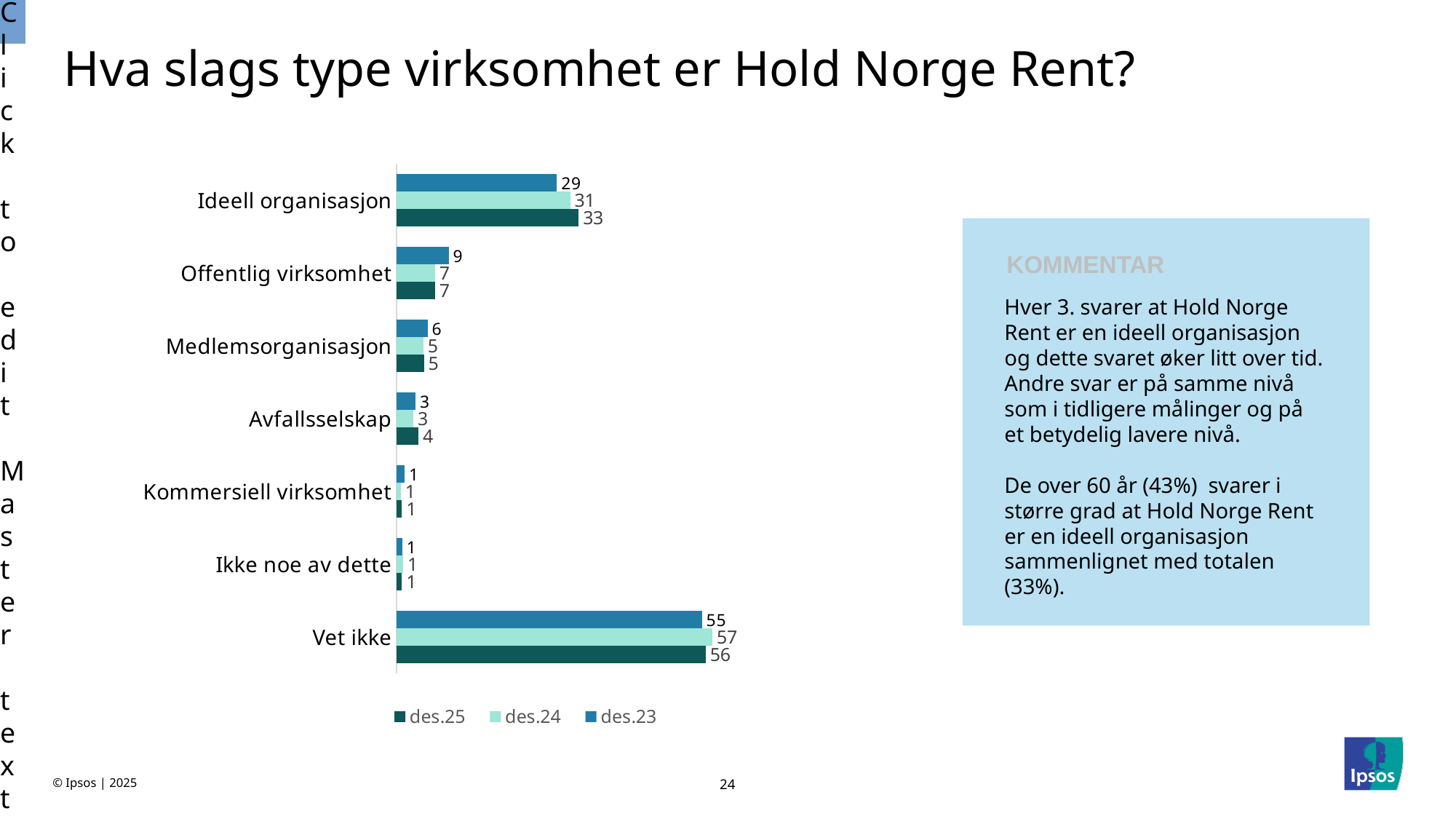
Which category has the highest value in the des.25 series? Vet ikke What is the value for Avfallsselskap in the des.25 series? 4 Which category has the lowest value in the des.23 series? Kommersiell virksomhet and Ikke noe av dette (both 1) Which series is shown in the darkest colour in the legend? des.25 What is the difference between the des.25 and des.23 values for Ideell organisasjon? 4 Which is larger for Vet ikke: the des.24 value or the des.23 value? des.24 What is the value for Ideell organisasjon in the des.25 series? 33 How many series does the legend list? 3 What kind of chart is shown on the slide? Bar chart What is the value for Vet ikke in the des.24 series? 57 How many categories are shown on the chart? 7 What is the value for Offentlig virksomhet in the des.23 series? 9